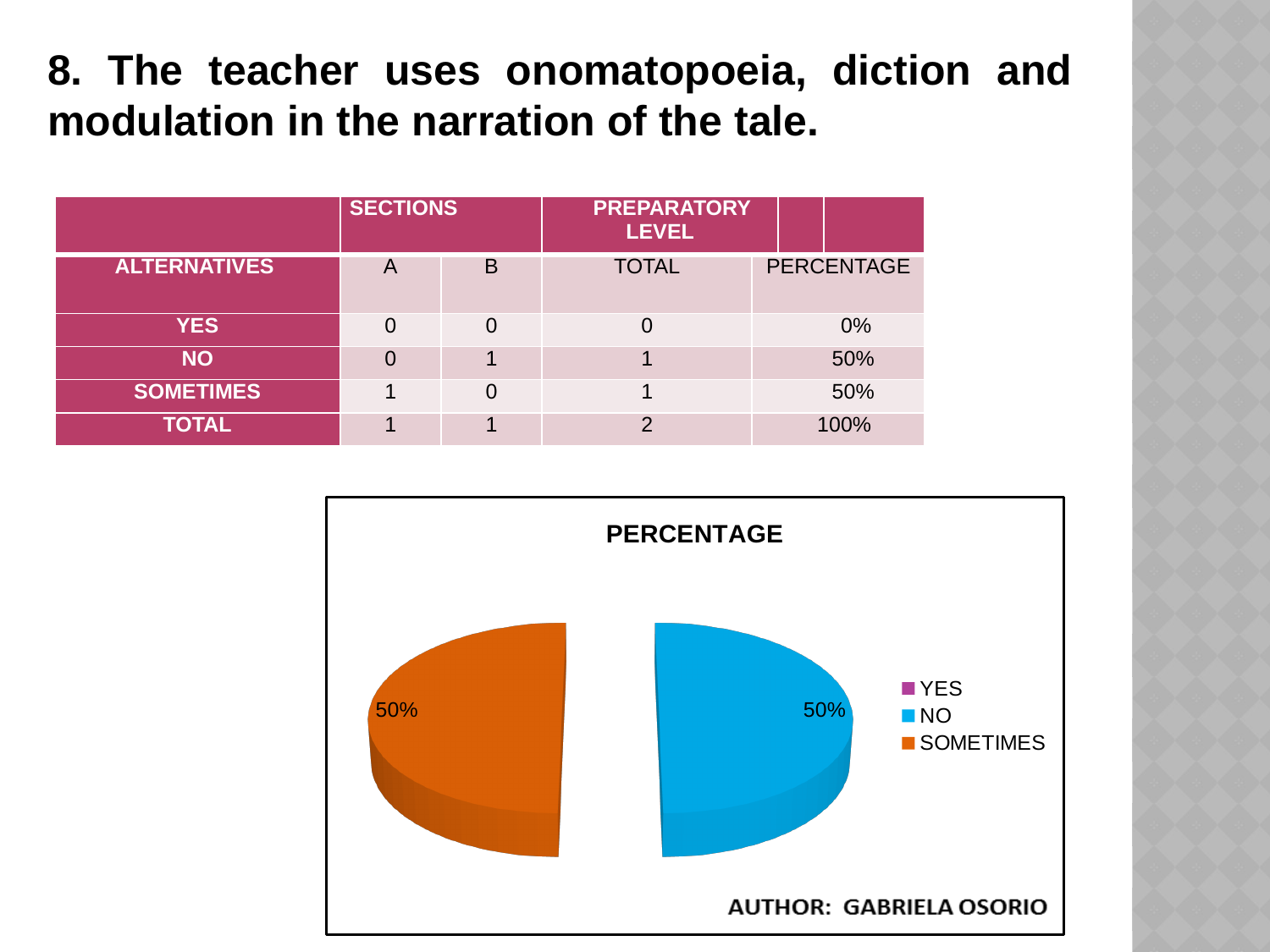
What colour is the NO slice in the pie chart? blue What is the title of the chart? PERCENTAGE Is the share for NO greater or less than 75%? less What kind of chart is shown on the slide? pie chart Is the share for SOMETIMES greater or less than 25%? greater What share of the pie does the SOMETIMES slice represent? 50% What share of the pie does the NO slice represent? 50% What is the difference between the NO share and the SOMETIMES share? 0% How many slices are visibly drawn in the pie chart? 2 How many entries does the chart's legend list? 3